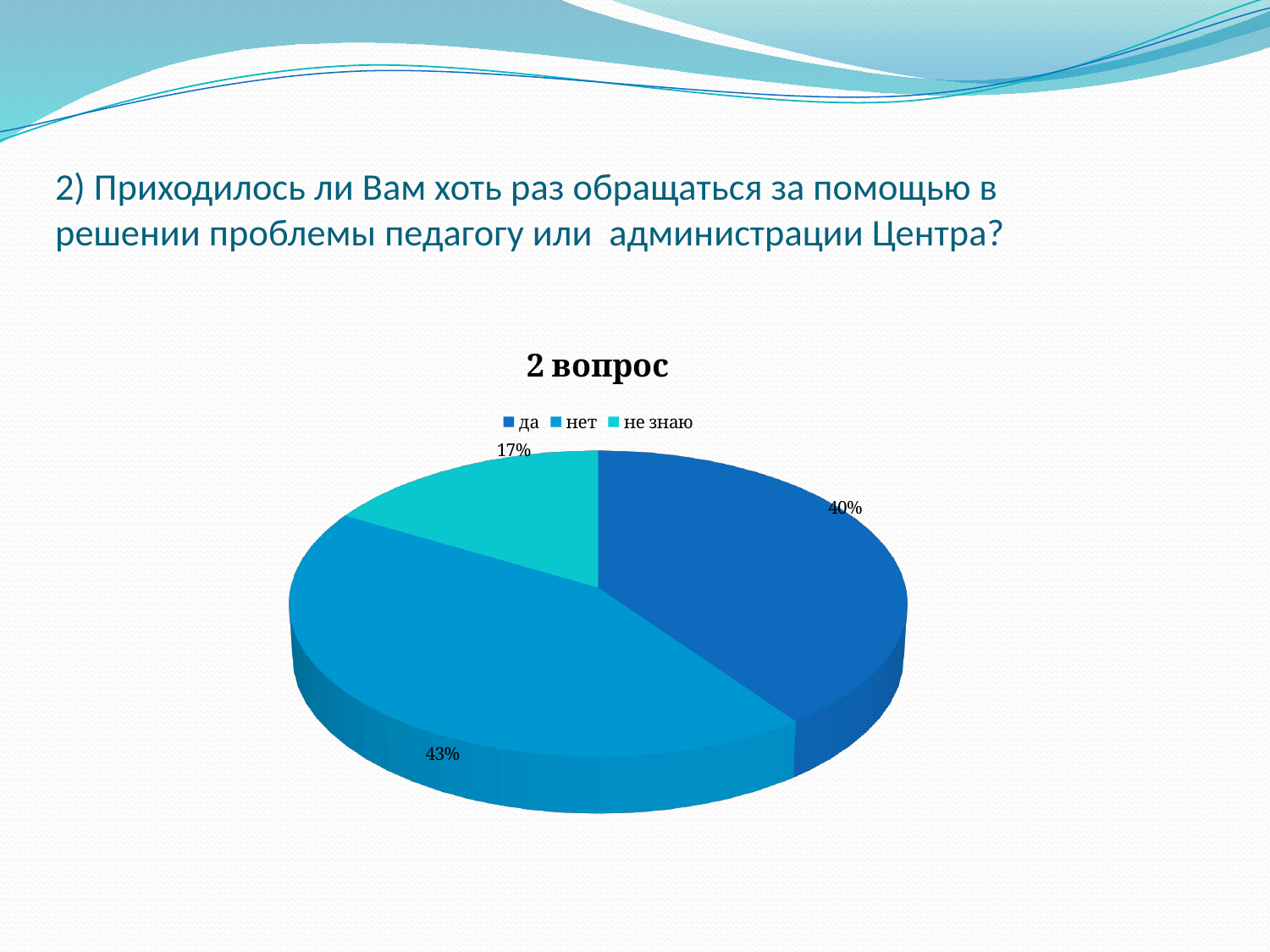
How many entries does the legend list? 3 What type of chart is shown on the slide? pie chart What share of the pie is labelled "не знаю"? 17% What share of the pie is labelled "нет"? 43% What share of the pie is labelled "да"? 40% Which category has the smallest share of the pie? не знаю Which is larger, the share for "да" or the share for "не знаю"? да What is the difference between the shares for "нет" and "да"? 3% Which category has the largest share of the pie? нет What is the difference between the shares for "да" and "не знаю"? 23% How many slices does the pie chart have? 3 What is the title of the chart? 2 вопрос